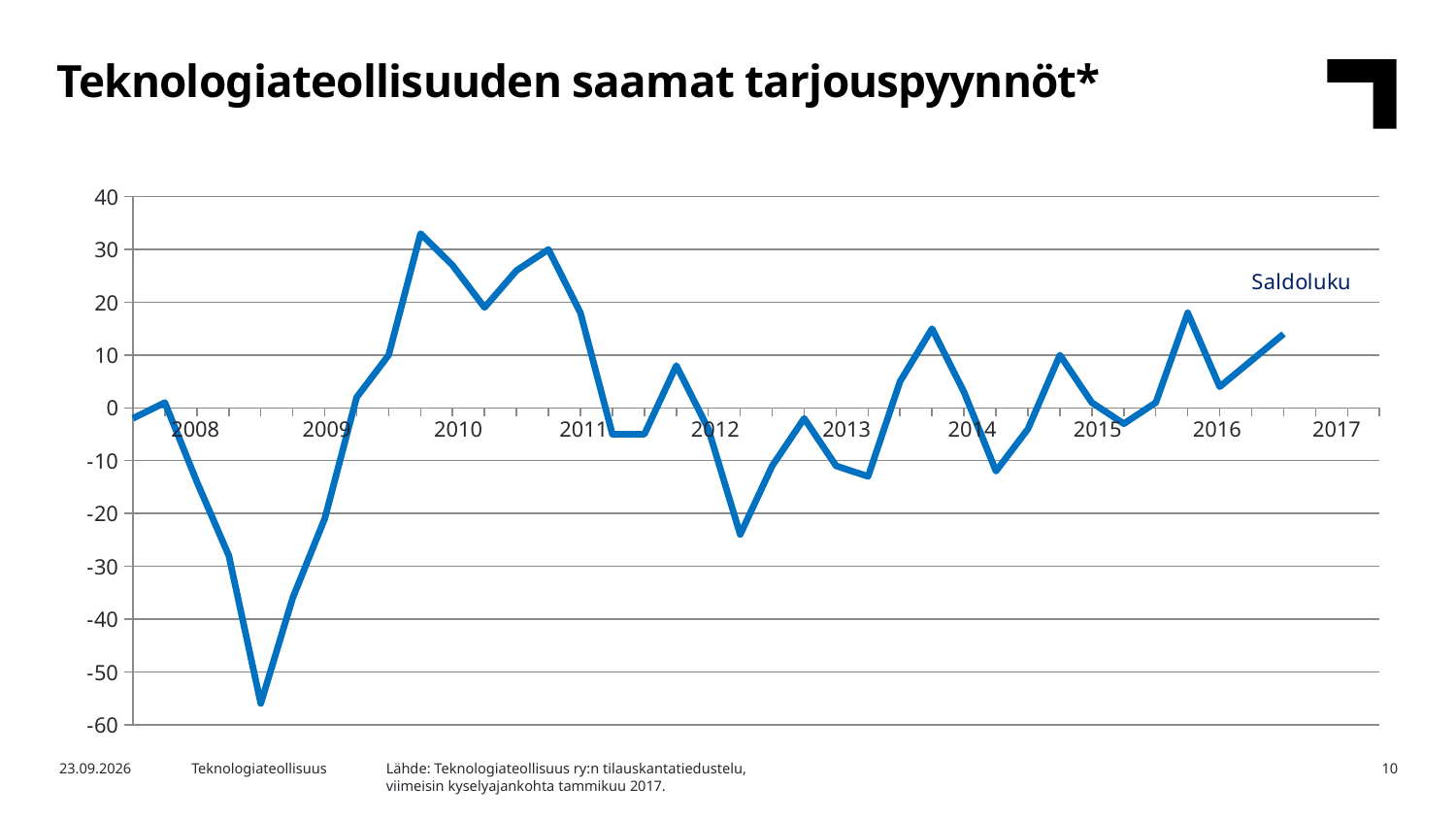
What kind of chart is shown on the slide? line chart How many year labels are shown on the x axis? 10 How many series are plotted on the chart? 1 In which year does the line reach its lowest point? 2009 Is the highest value on the line greater or less than 20? greater Is the lowest value reached in 2012 greater or less than -20? less What is the name of the series plotted on the chart? Saldoluku What is the title of the chart? Teknologiateollisuuden saamat tarjouspyynnöt* Is the lowest value on the line greater or less than -50? less